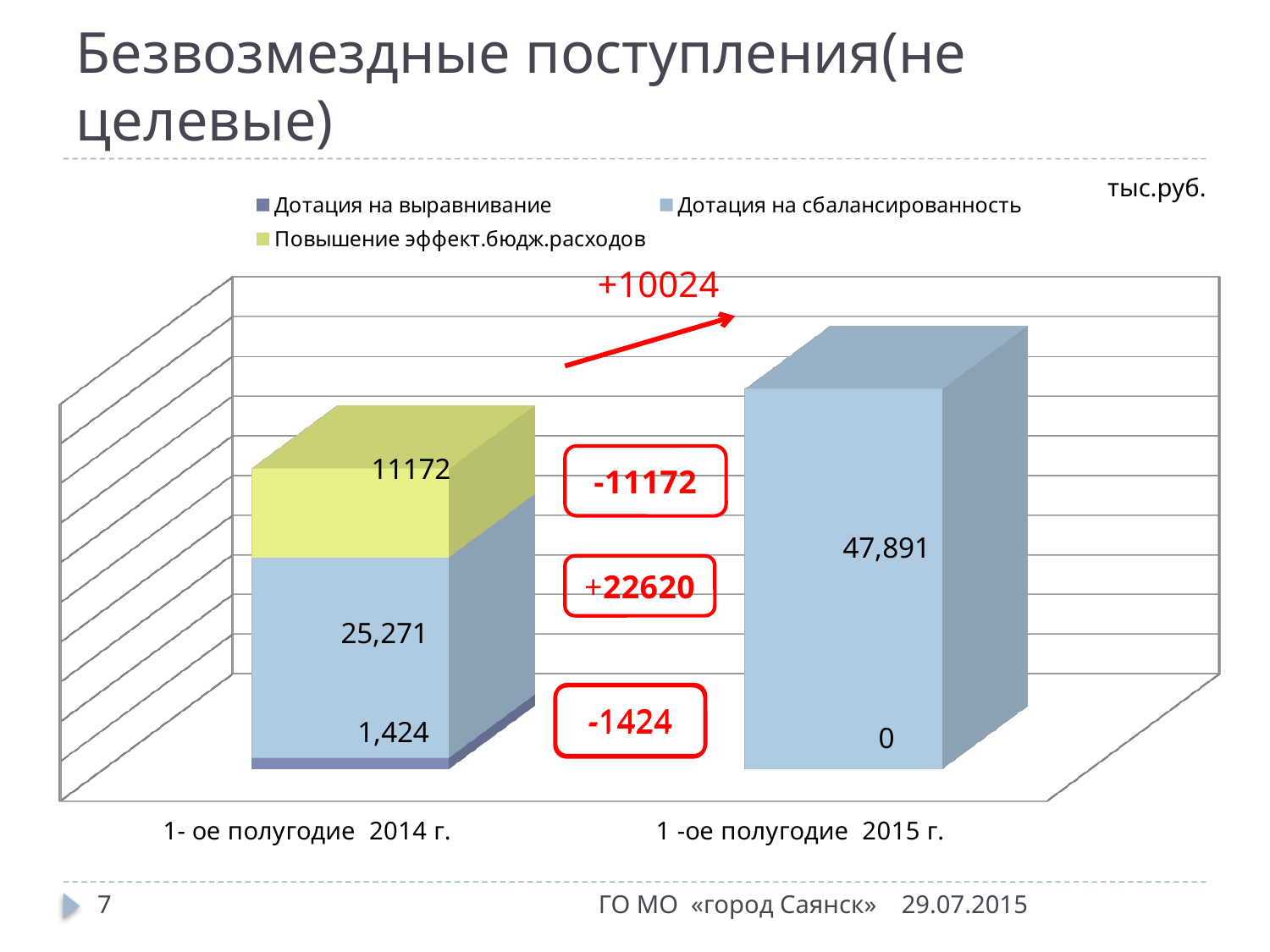
What is the value of Дотация на выравнивание for 1-ое полугодие 2015 г.? 0 Which period has the larger value for Дотация на сбалансированность? 1-ое полугодие 2015 г. What kind of chart is shown on the slide? stacked bar chart What is the value of Дотация на выравнивание for 1-ое полугодие 2014 г.? 1,424 What is the total of the stacked bar for 1-ое полугодие 2014 г.? 37867 What is the value of Дотация на сбалансированность for 1-ое полугодие 2014 г.? 25,271 What is the value of Дотация на сбалансированность for 1-ое полугодие 2015 г.? 47,891 How many categories are shown on the x axis? 2 What is the difference in Дотация на сбалансированность between 1-ое полугодие 2015 г. and 1-ое полугодие 2014 г.? 22620 What unit is indicated for the chart values? тыс.руб. What is the value of Повышение эффект.бюдж.расходов for 1-ое полугодие 2014 г.? 11172 How many series does the legend list? 3